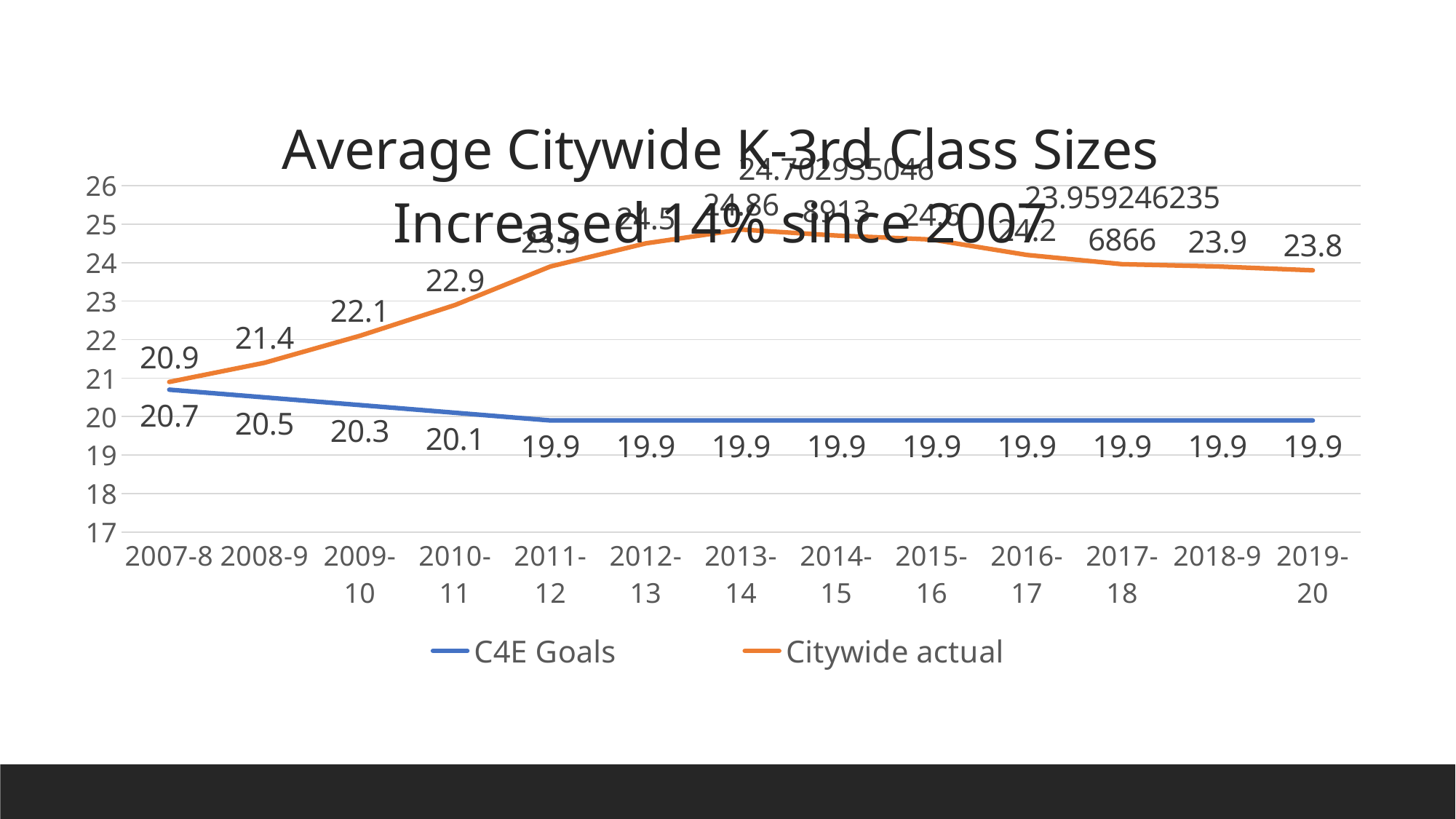
In which school year is the Citywide actual class size lowest? 2007-8 In 2009-10, which is larger: the Citywide actual value or the C4E Goals value? Citywide actual What is the C4E Goals value for 2019-20? 19.9 How many school years are shown on the x axis? 13 What is the C4E Goals value for 2008-9? 20.5 What kind of chart is shown on the slide? Line chart In which school year is the Citywide actual class size highest? 2013-14 Is the Citywide actual value for 2010-11 greater or less than 22? greater What is the Citywide actual value for 2009-10? 22.1 What is the difference between the Citywide actual and C4E Goals values in 2019-20? 3.9 What is the Citywide actual value for 2007-8? 20.9 How many series does the legend list? 2